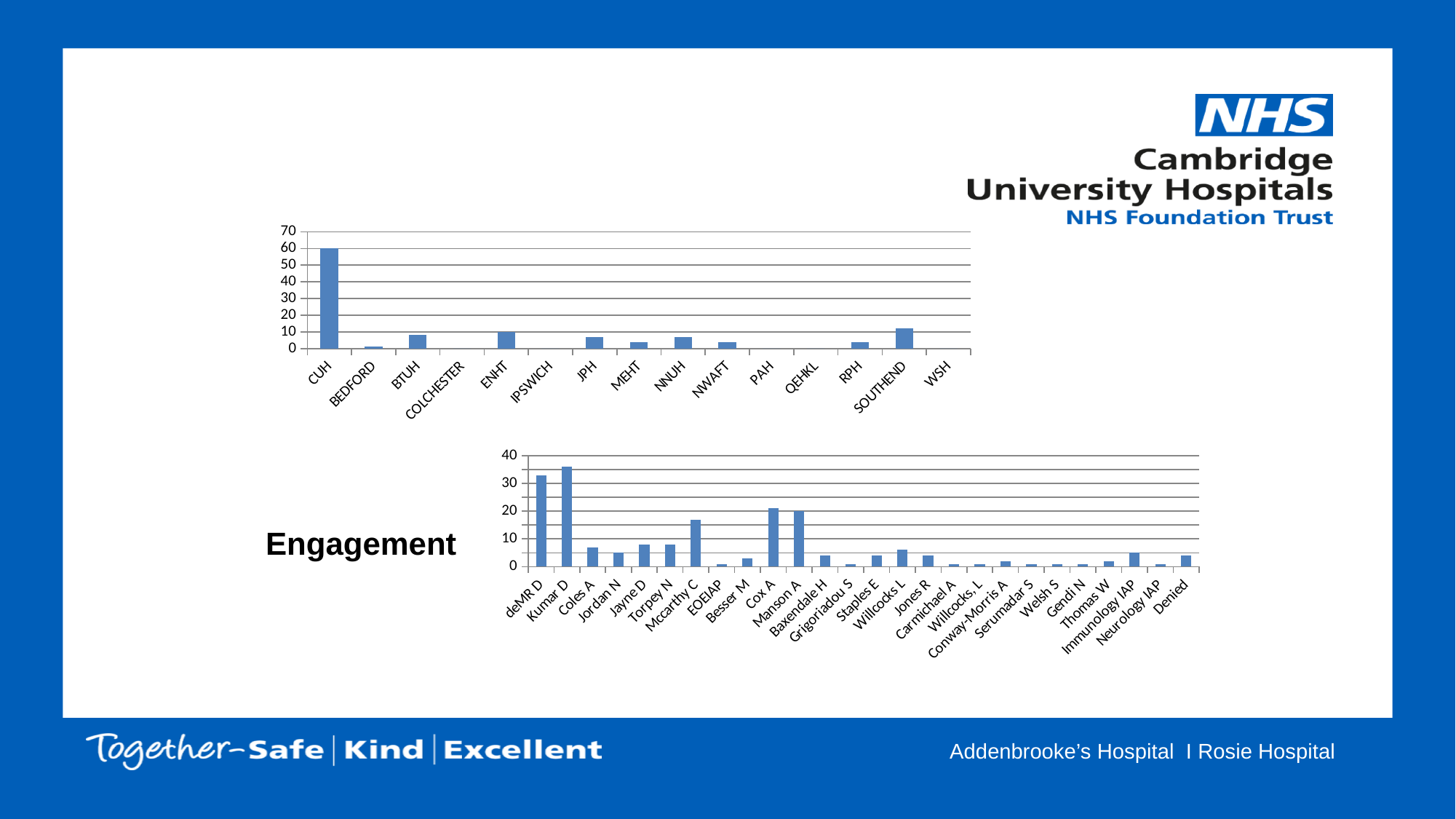
What label is written to the left of the bottom chart? Engagement In the top chart, which is larger, the value for SOUTHEND or the value for ENHT? SOUTHEND In the top chart, is the value for CUH greater or less than 50? greater In the top chart, is the value for SOUTHEND greater or less than 10? greater In the bottom Engagement chart, is the value for Mccarthy C greater or less than 20? less In the bottom Engagement chart, which category has the highest value? Kumar D In the top chart, which hospital has the highest value? CUH In the top chart, how many hospital categories are shown on the x axis? 15 What kind of chart is the top chart showing hospitals such as CUH and BEDFORD? bar chart In the bottom Engagement chart, which is larger, the value for Cox A or the value for Mccarthy C? Cox A